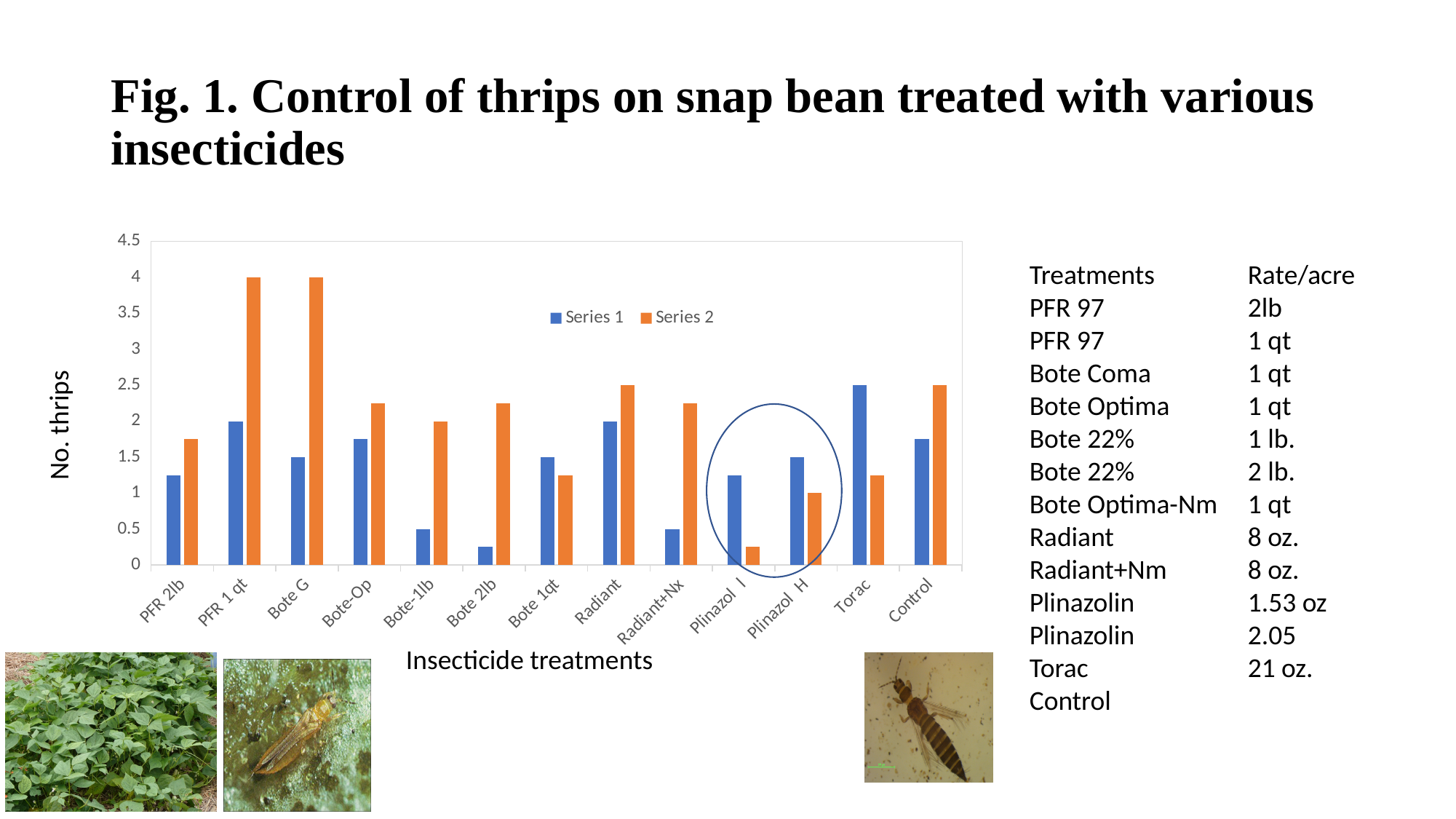
For Torac, which series has the larger value, Series 1 or Series 2? Series 1 Which treatment has the highest Series 1 value? Torac For Bote 2lb, which series has the larger value, Series 1 or Series 2? Series 2 What kind of chart is shown on the slide? bar chart Is the Series 2 value for PFR 1 qt greater or less than 3.5? greater What is the label on the y axis of the chart? No. thrips Is the Series 2 value for Plinazol I greater or less than 0.5? less How many series does the chart legend list? 2 Which treatment has the lowest Series 1 value? Bote 2lb Is the Series 1 value for Bote-1lb greater or less than 1? less How many insecticide treatment categories are shown on the x axis? 13 Which treatment has the lowest Series 2 value? Plinazol I